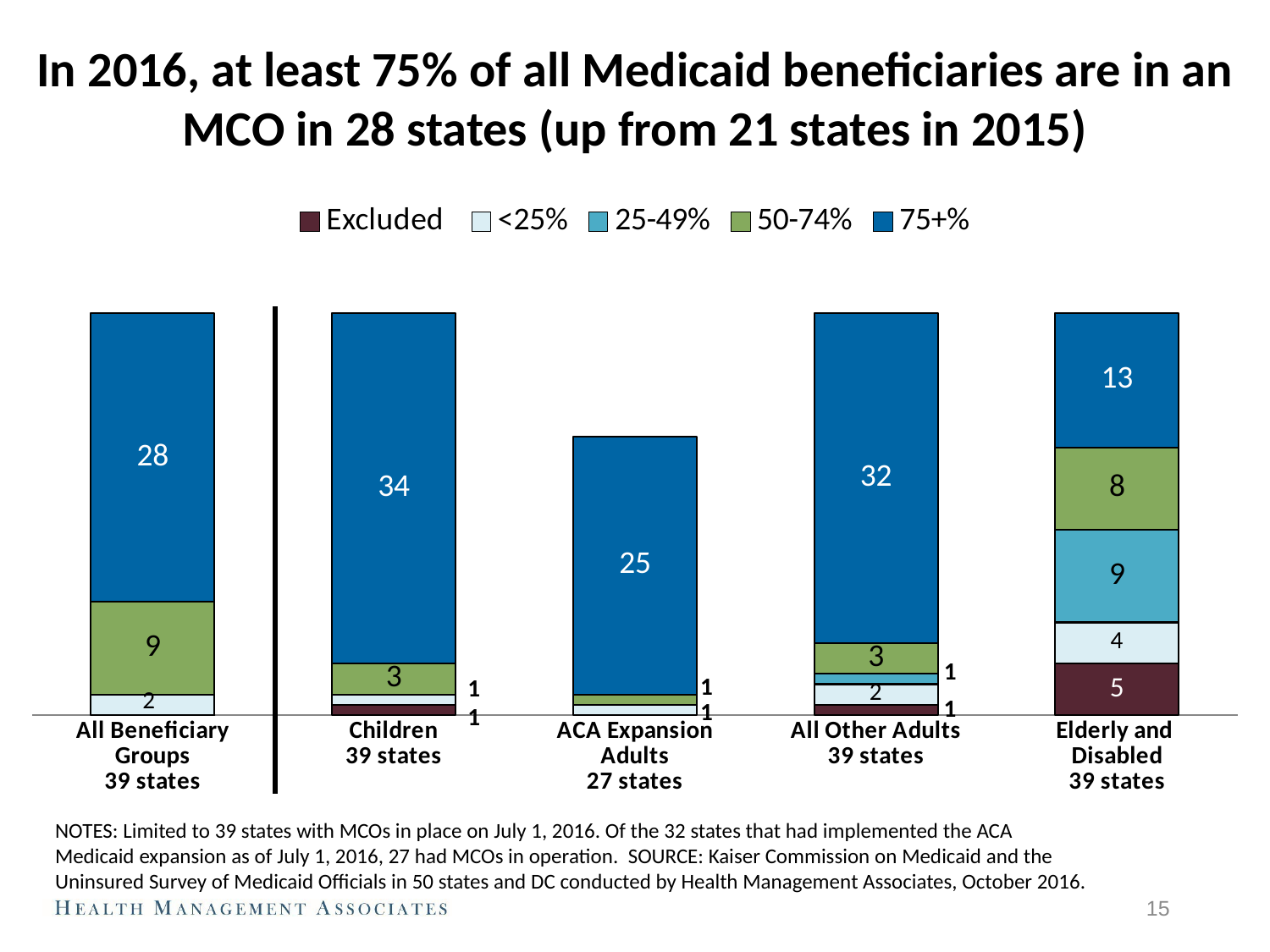
What is the value of the Excluded segment for Elderly and Disabled? 5 What is the total of the stacked bar for Elderly and Disabled? 39 For Elderly and Disabled, which is larger: the 25-49% segment or the 50-74% segment? 25-49% How many series does the legend list? 5 What is the value of the 75+% segment for Elderly and Disabled? 13 What is the difference between the 75+% value for Children and the 75+% value for Elderly and Disabled? 21 What kind of chart is shown on the slide? Stacked bar chart How many categories (bars) are shown on the chart? 5 What is the value of the 50-74% segment for All Beneficiary Groups? 9 Which category has the largest 75+% segment? Children What is the value of the 75+% segment for Children? 34 Which category has the smallest 75+% segment? Elderly and Disabled